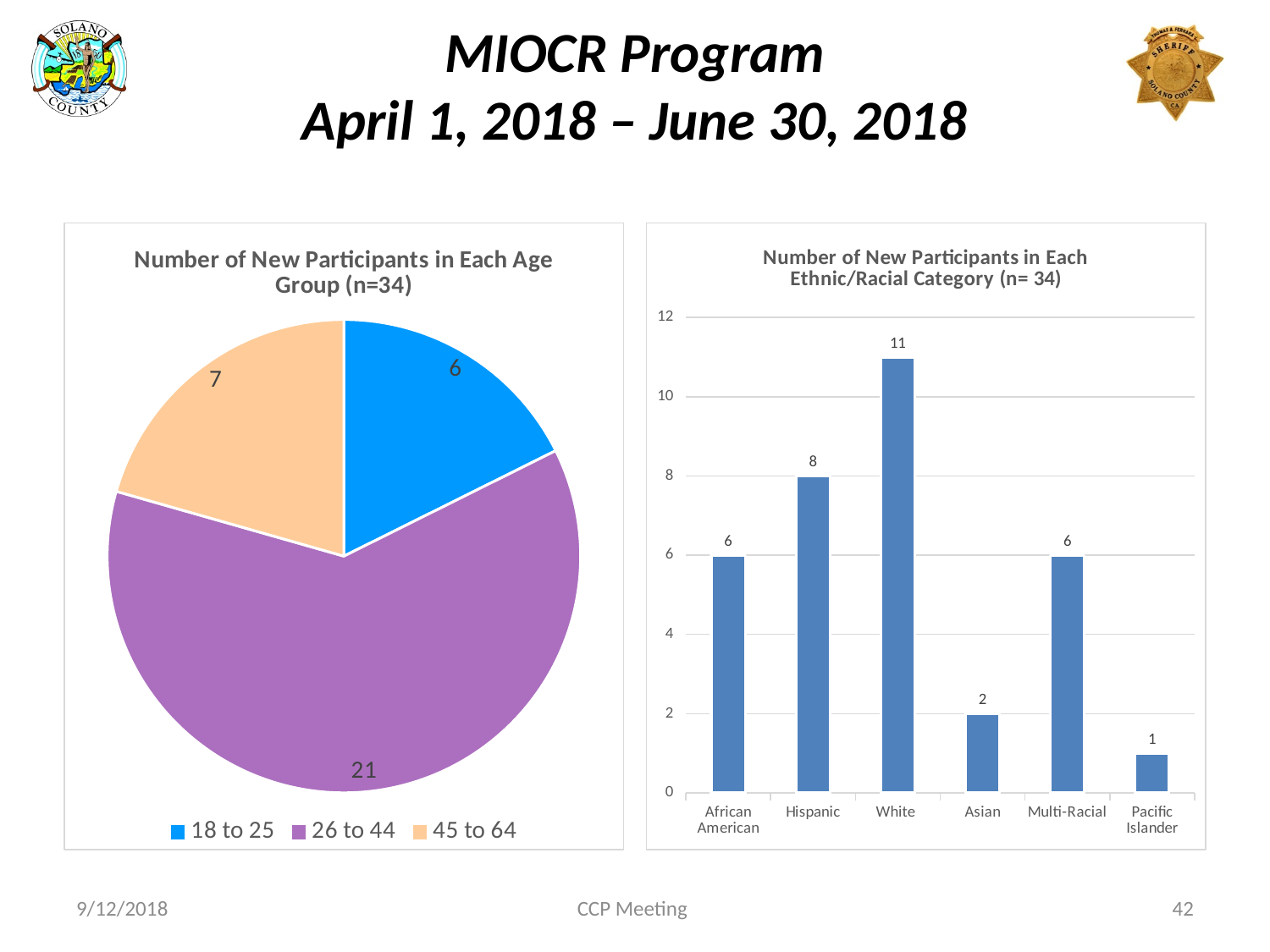
In the 'Number of New Participants in Each Age Group' chart, which age group has the fewest new participants? 18 to 25 In the 'Number of New Participants in Each Ethnic/Racial Category' chart, which is larger, Hispanic or Multi-Racial? Hispanic In the 'Number of New Participants in Each Age Group' chart, how many new participants are in the 26 to 44 age group? 21 In the 'Number of New Participants in Each Ethnic/Racial Category' chart, what is the difference between the White and Asian categories? 9 In the 'Number of New Participants in Each Age Group' chart, how many age groups does the legend list? 3 In the 'Number of New Participants in Each Ethnic/Racial Category' chart, how many ethnic/racial categories are shown? 6 In the 'Number of New Participants in Each Ethnic/Racial Category' chart, which category has the highest number of new participants? White In the 'Number of New Participants in Each Ethnic/Racial Category' chart, which category has the lowest number of new participants? Pacific Islander In the 'Number of New Participants in Each Ethnic/Racial Category' chart, what kind of chart is shown? bar chart In the 'Number of New Participants in Each Age Group' chart, what kind of chart is shown? pie chart In the 'Number of New Participants in Each Ethnic/Racial Category' chart, how many new participants are Hispanic? 8 In the 'Number of New Participants in Each Age Group' chart, what is the difference between the 45 to 64 and 18 to 25 groups? 1